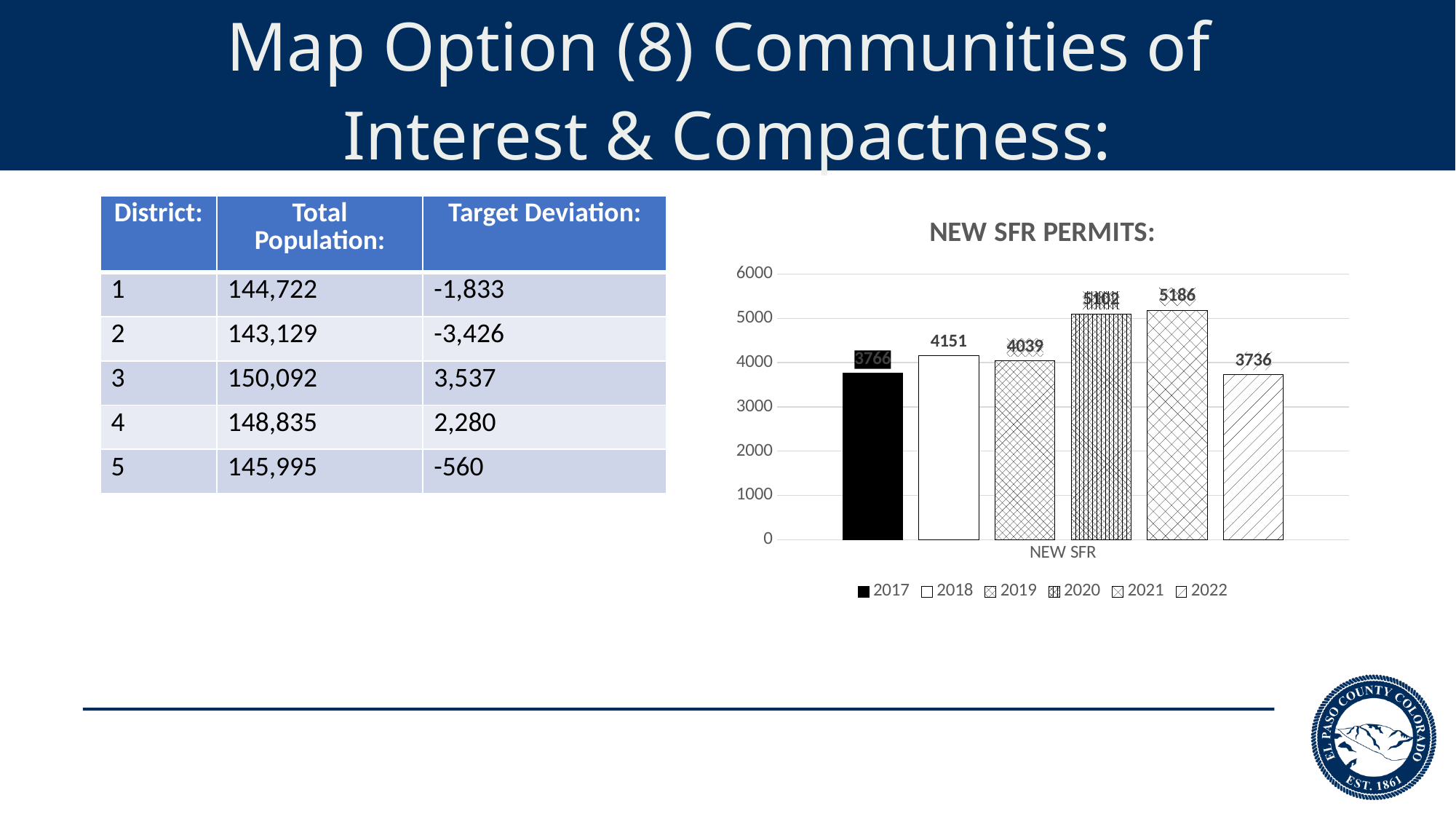
What is the value for 2017 in the NEW SFR PERMITS chart? 3766 In the NEW SFR PERMITS chart, which is larger, the value for 2018 or the value for 2019? 2018 What is the value for 2022 in the NEW SFR PERMITS chart? 3736 What kind of chart is the NEW SFR PERMITS chart? bar chart In the NEW SFR PERMITS chart, is the value for 2020 greater or less than 5000? greater What is the value for 2019 in the NEW SFR PERMITS chart? 4039 How many series does the legend of the NEW SFR PERMITS chart list? 6 In the NEW SFR PERMITS chart, what is the difference between the 2021 and 2022 values? 1450 What is the value for 2018 in the NEW SFR PERMITS chart? 4151 In the NEW SFR PERMITS chart, what is the difference between the 2018 and 2019 values? 112 What is the title of the chart on the slide? NEW SFR PERMITS: What is the value for 2021 in the NEW SFR PERMITS chart? 5186